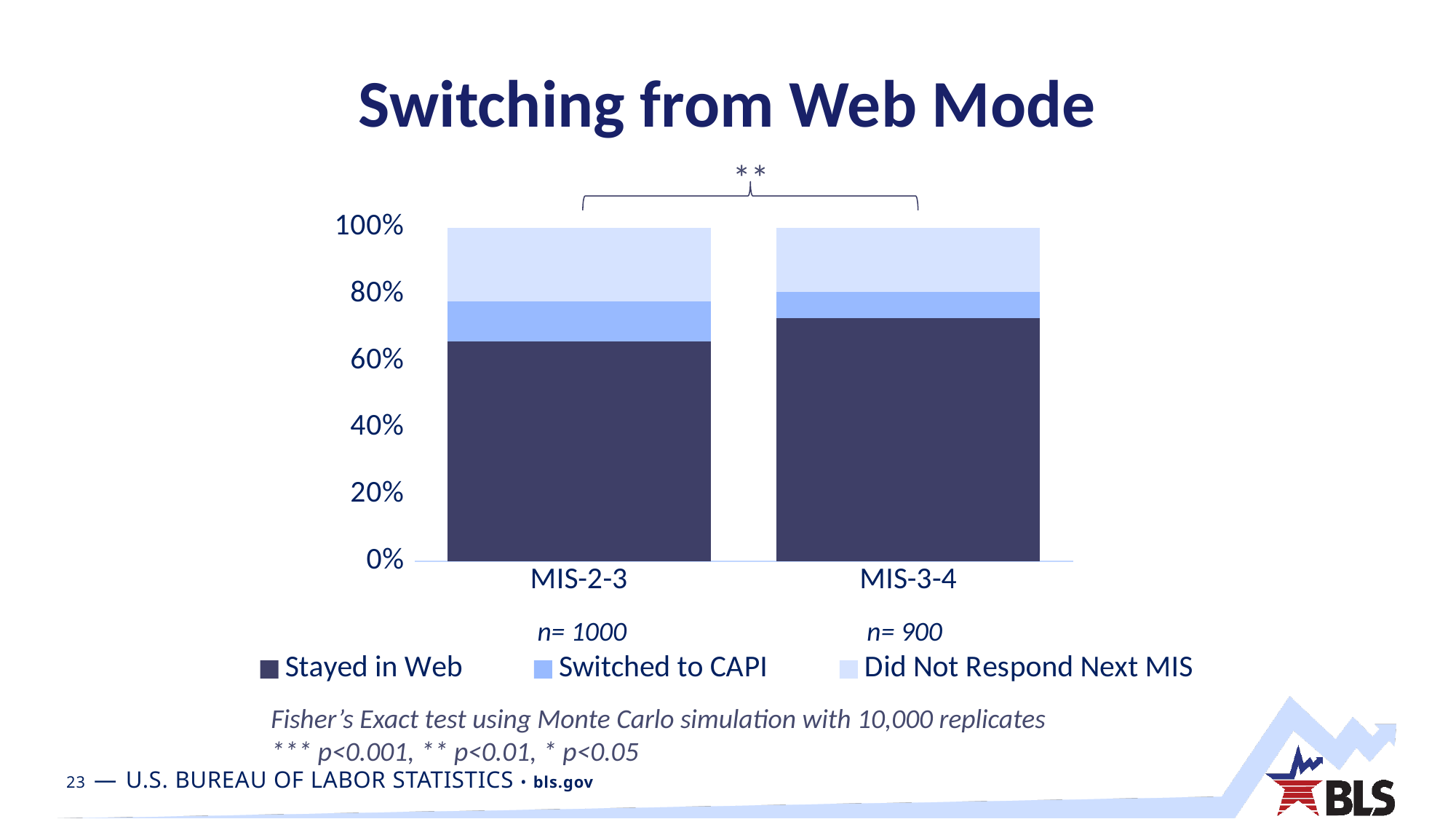
Which category has the larger Stayed in Web share, MIS-2-3 or MIS-3-4? MIS-3-4 What is the total height of the stacked bar for MIS-2-3? 100% Which series is shown in the darkest colour at the bottom of each bar? Stayed in Web Is the Switched to CAPI share for MIS-3-4 greater or less than 20%? less Is the Stayed in Web share for MIS-3-4 greater or less than 80%? less How many series does the legend list? 3 Is the Stayed in Web share for MIS-2-3 greater or less than 60%? greater What is the sample size (n) shown for MIS-3-4? 900 What kind of chart is shown on the slide? Stacked bar chart Which category has the larger Switched to CAPI share, MIS-2-3 or MIS-3-4? MIS-2-3 What is the title of the chart? Switching from Web Mode How many categories are shown on the x axis? 2